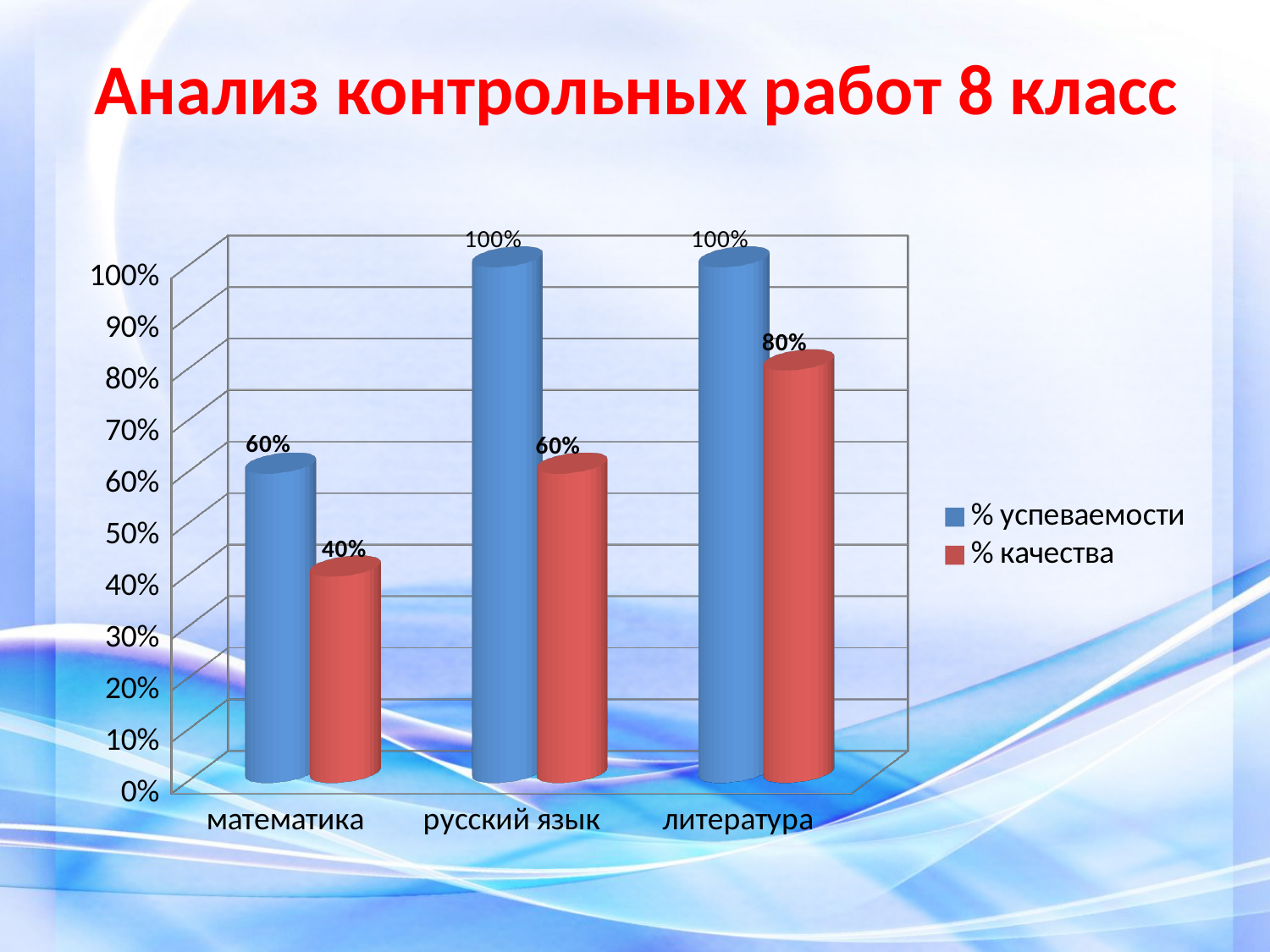
What colour represents % качества in the legend? red What is the difference between % успеваемости and % качества for математика? 20% How many series does the legend list? 2 Which subject has the lowest % качества? математика Which is larger: % качества for русский язык or % качества for литература? литература What is the difference in % качества between литература and русский язык? 20% Which subject has the highest % качества? литература What is the % качества value for русский язык? 60% What kind of chart is shown on the slide? bar chart How many subjects are shown on the x axis? 3 What is the % успеваемости value for математика? 60% What is the % качества value for литература? 80%